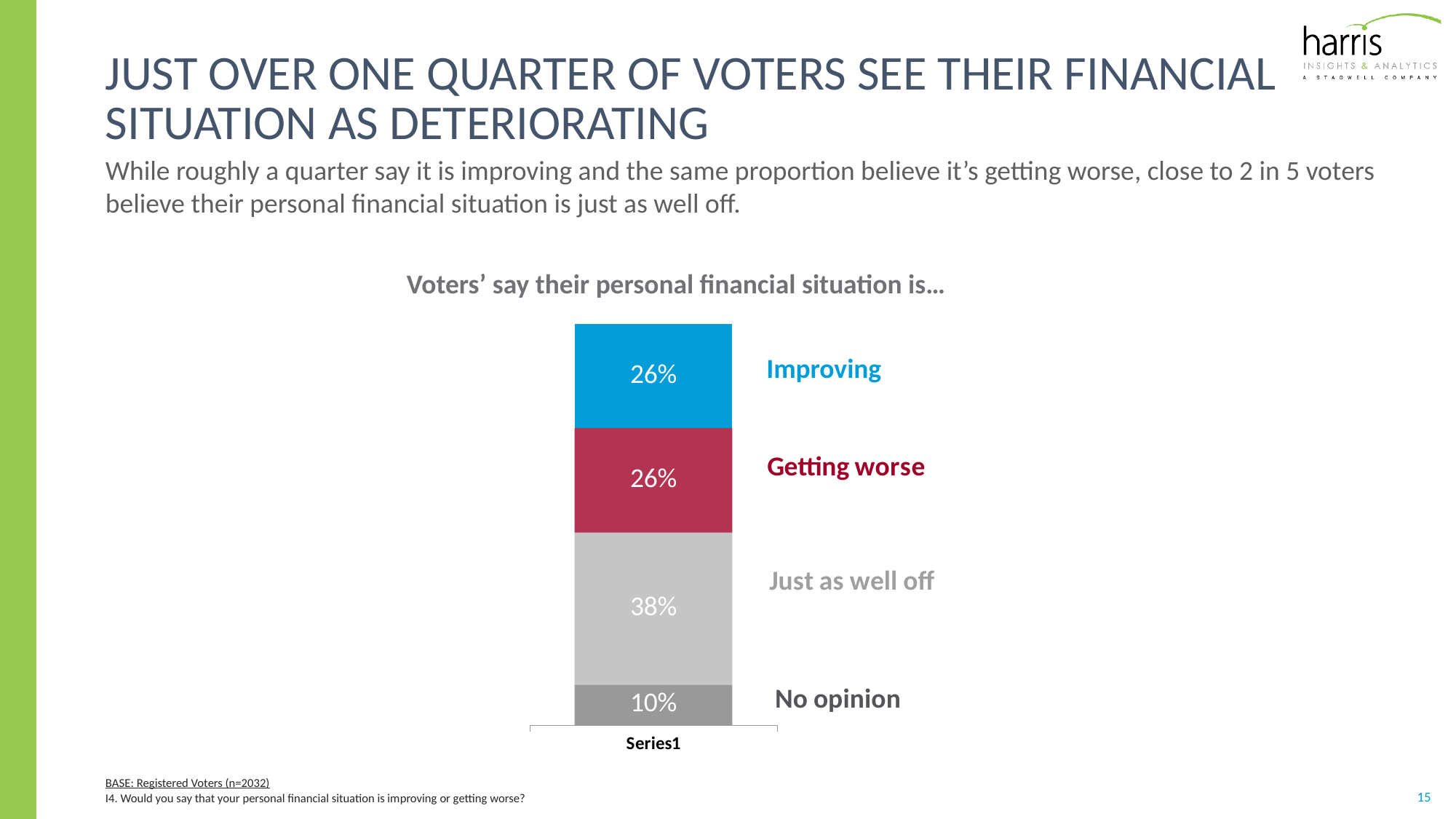
What is the difference between the share saying 'Just as well off' and the share saying 'Improving'? 12 percentage points How many segments make up the stacked bar? 4 Which response has the largest share of voters? Just as well off What percentage of voters say they are just as well off? 38% What percentage of voters have no opinion on their personal financial situation? 10% What is the total of all segments in the stacked bar? 100% Which response has the smallest share of voters? No opinion What type of chart is shown on the slide? Stacked bar chart Which is larger: the share saying 'Just as well off' or the share saying 'Getting worse'? Just as well off What percentage of voters say their personal financial situation is improving? 26% What is the difference between the share saying 'Getting worse' and the share with 'No opinion'? 16 percentage points What percentage of voters say their personal financial situation is getting worse? 26%